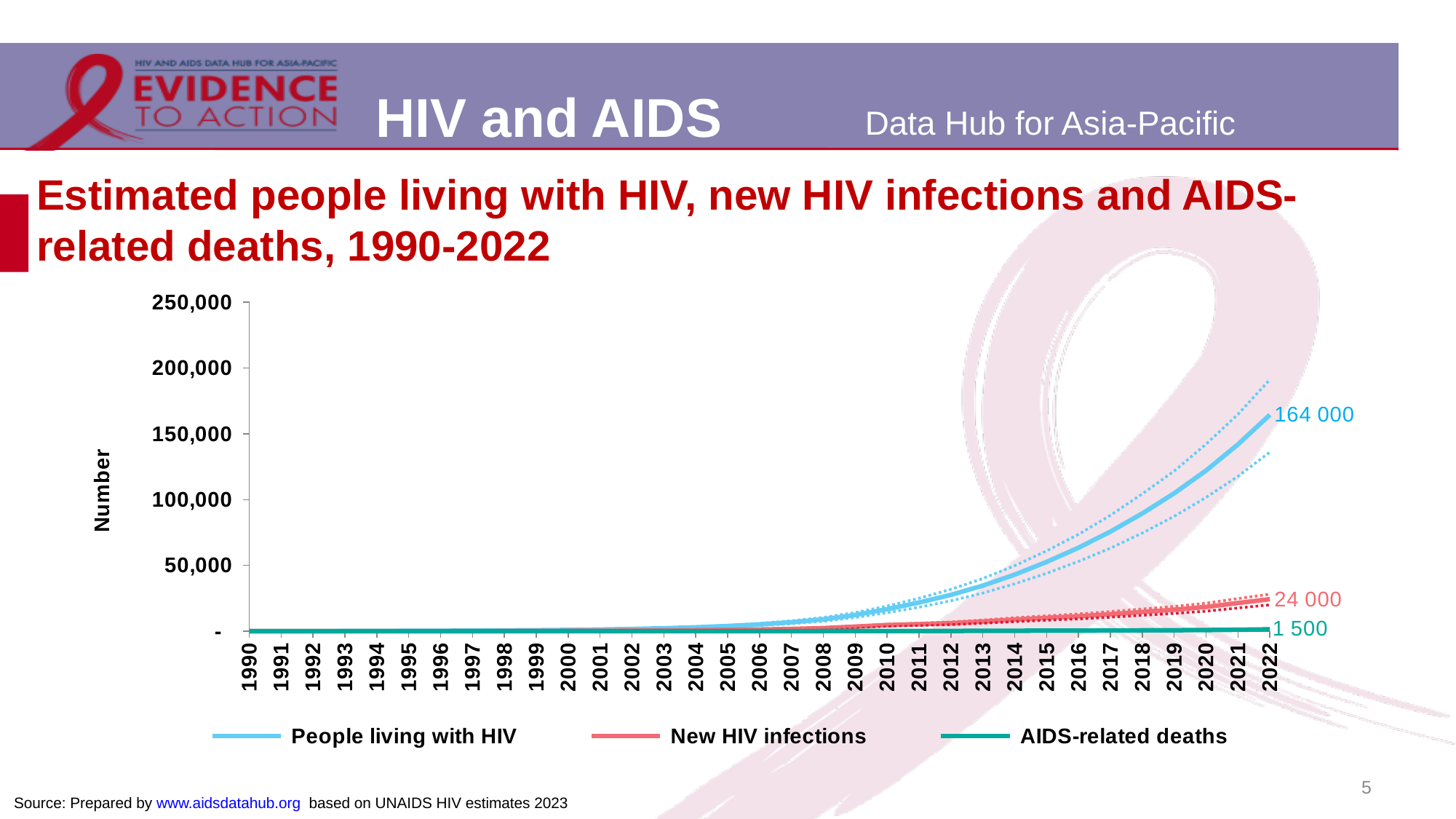
How many years are shown on the x axis? 33 How many series does the legend list? 3 Which series has the lowest value in 2022? AIDS-related deaths Is the value for People living with HIV in 2015 greater or less than 100,000? less What is the difference between People living with HIV and New HIV infections in 2022? 140 000 What is the value for AIDS-related deaths in 2022? 1 500 In 2022, which is larger: New HIV infections or AIDS-related deaths? New HIV infections Does the People living with HIV line rise or fall from 1990 to 2022? rise What kind of chart is shown on the slide? line chart What is the value for New HIV infections in 2022? 24 000 What is the value for People living with HIV in 2022? 164 000 Which series has the highest value in 2022? People living with HIV